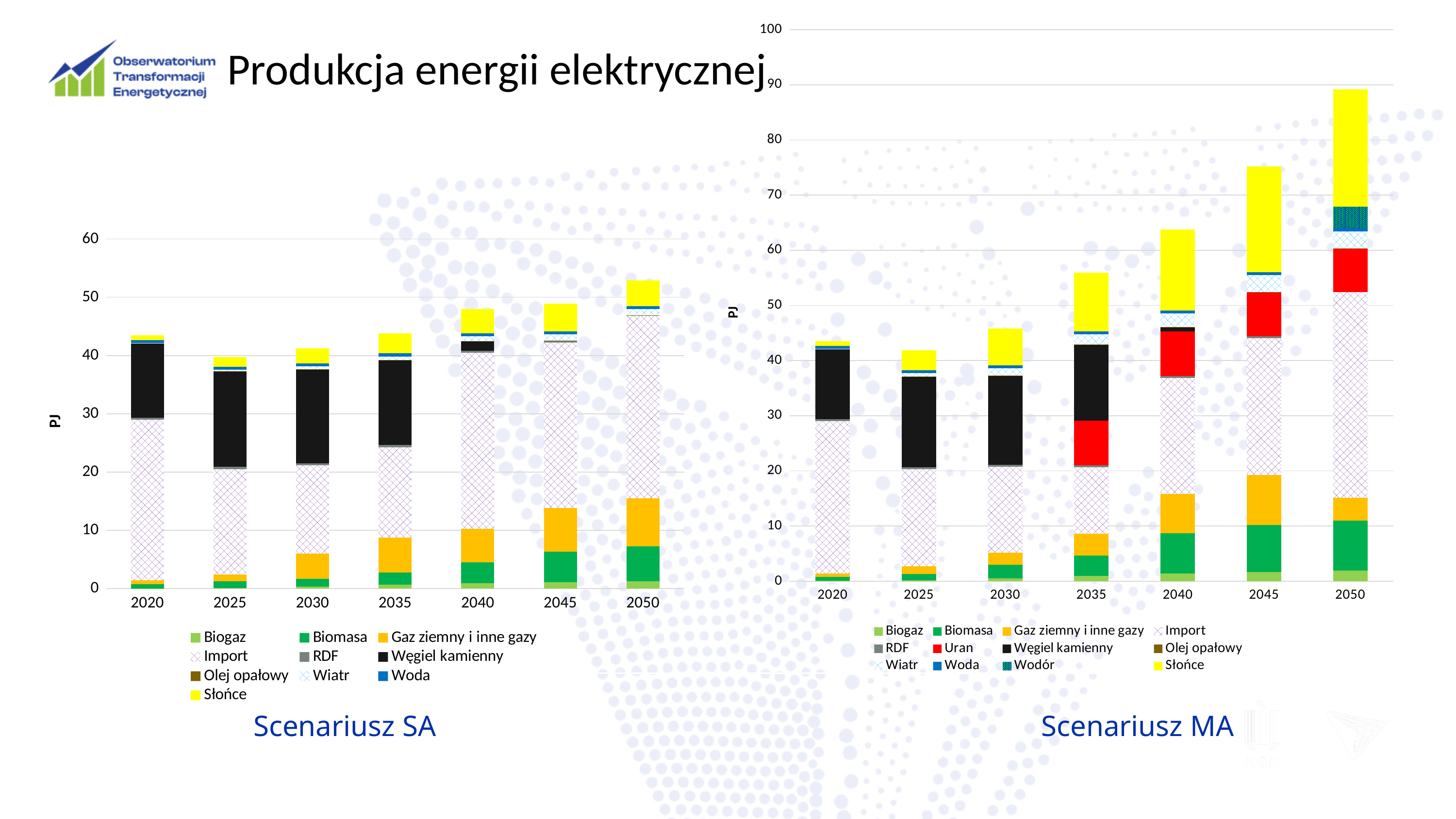
In the "Scenariusz MA" chart, which year has the highest total bar? 2050 In the "Scenariusz SA" chart, how many years are shown on the x axis? 7 In the "Scenariusz MA" chart, which total bar is larger, 2035 or 2045? 2045 In the "Scenariusz MA" chart, do the total bars rise or fall from 2035 to 2050? rise What kind of chart is shown under "Scenariusz SA"? stacked bar chart How many series does the legend of the "Scenariusz MA" chart list? 12 In the "Scenariusz SA" chart, which year has the highest total bar? 2050 Which series appear in the legend of the "Scenariusz MA" chart but not in the "Scenariusz SA" chart? Uran and Wodór In the "Scenariusz MA" chart, is the total for 2020 greater or less than 50? less In the "Scenariusz MA" chart, is the total for 2050 greater or less than 80? greater In the "Scenariusz SA" chart, is the total for 2050 greater or less than 50? greater How many series does the legend of the "Scenariusz SA" chart list? 10